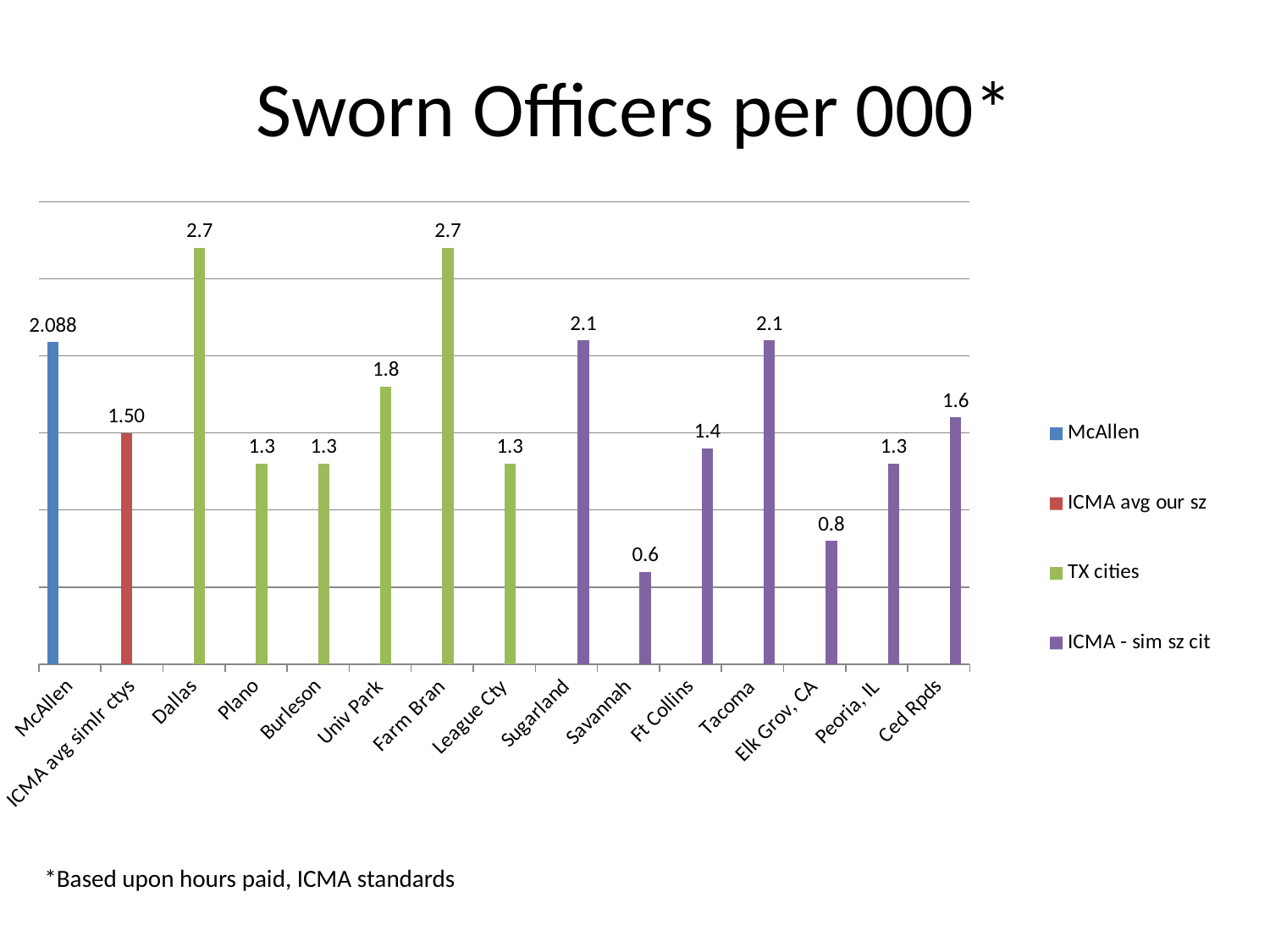
How many series does the legend list? 4 What is the value for ICMA avg simlr ctys? 1.50 Which is larger, the value for Sugarland or the value for Ft Collins? Sugarland What kind of chart is shown on the slide? Bar chart What is the value for Univ Park? 1.8 Which category has the lowest value? Savannah What is the difference between the values for Dallas and Plano? 1.4 What is the value for Savannah? 0.6 What is the value for Ced Rpds? 1.6 What is the value for McAllen? 2.088 How many categories are shown on the x axis? 15 What is the difference between the values for Tacoma and Elk Grov, CA? 1.3